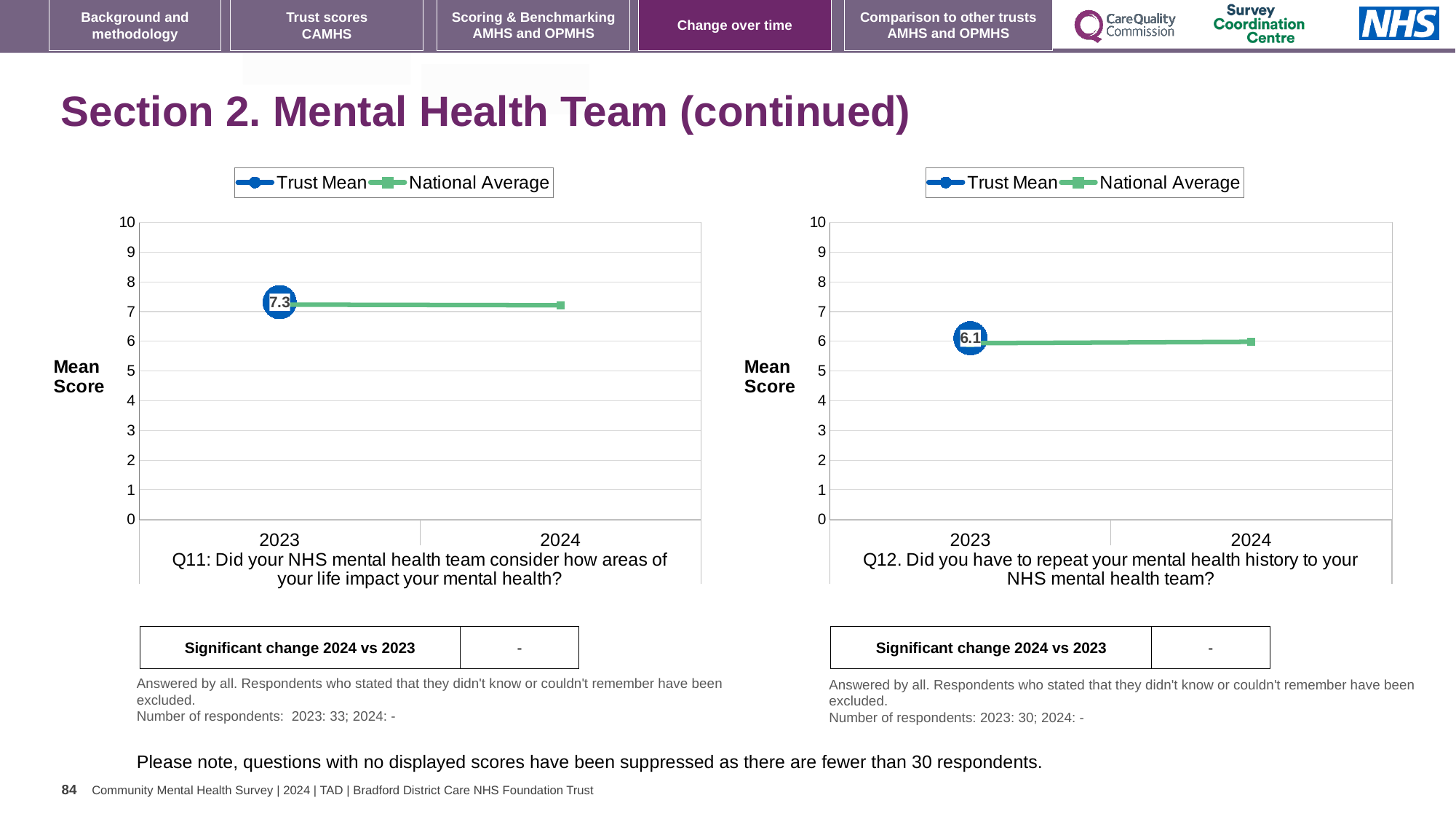
In the left chart (Q11), is the National Average value for 2023 greater or less than 9? less In the left chart (Q11), what is the Trust Mean score for 2023? 7.3 What is the label on the y axis of the right chart (Q12)? Mean Score What are the two series named in the legend of the left chart (Q11)? Trust Mean and National Average How many series does the legend of the right chart (Q12) list? 2 In the left chart (Q11), is the National Average value for 2024 greater or less than 5? greater What kind of chart is the left chart (Q11)? Line chart In the right chart (Q12), what is the Trust Mean score for 2023? 6.1 In the right chart (Q12), is the National Average value for 2024 greater or less than 8? less Which chart shows the higher Trust Mean for 2023, the left chart (Q11) or the right chart (Q12)? The left chart (Q11) How many years are shown on the x axis of the left chart (Q11)? 2 What is the difference between the 2023 Trust Mean in the left chart (Q11) and the 2023 Trust Mean in the right chart (Q12)? 1.2